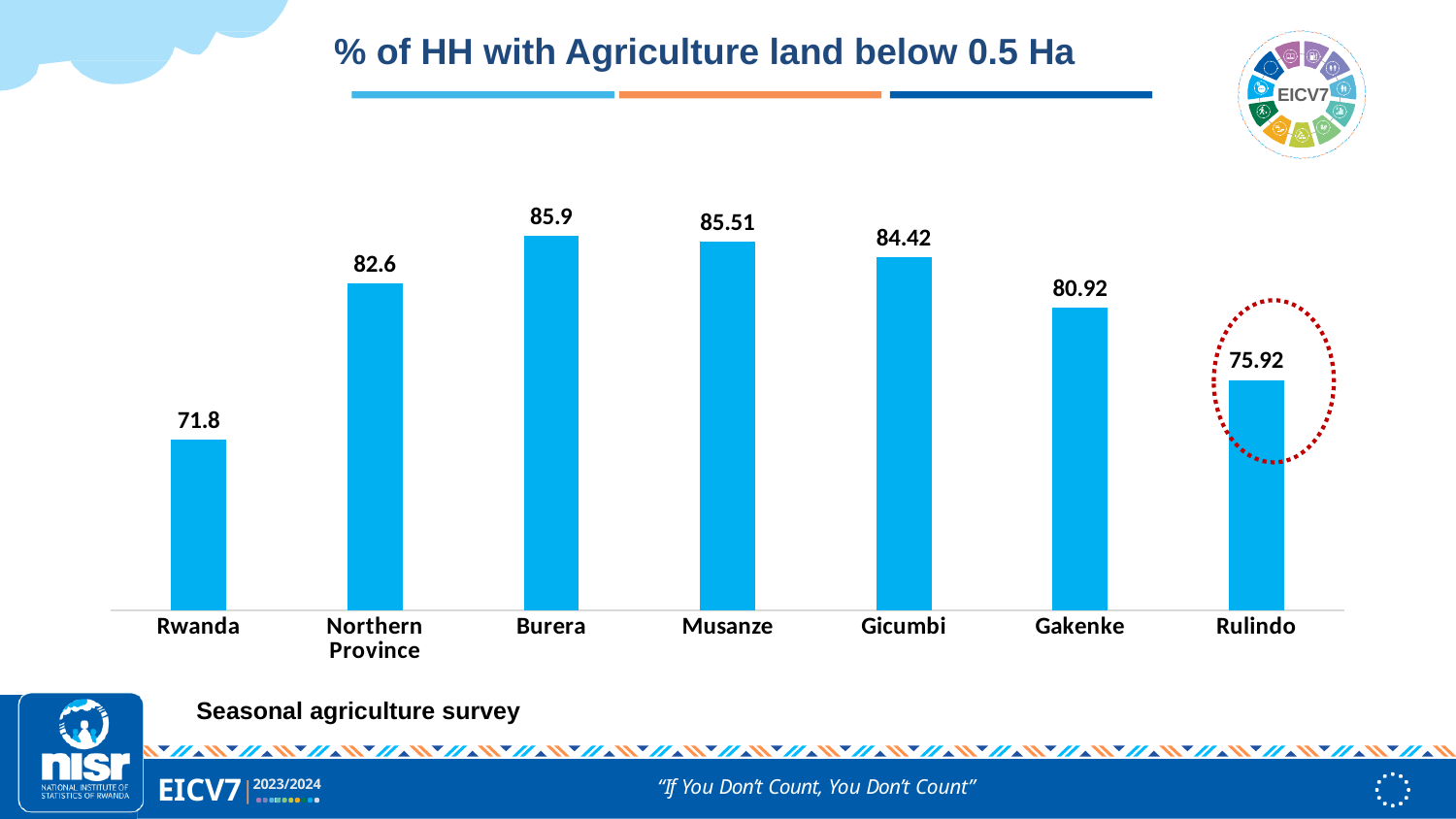
What is the difference between the values for Burera and Rulindo? 9.98 What is the value for Northern Province? 82.6 What is the value for Gicumbi? 84.42 What is the value for Rwanda? 71.8 Which is larger, the value for Gakenke or the value for Rulindo? Gakenke Which category has the highest value? Burera What kind of chart is shown on the slide? Bar chart What is the title of the chart? % of HH with Agriculture land below 0.5 Ha What is the value for Rulindo? 75.92 How many categories are shown on the x axis? 7 Which category has the lowest value? Rwanda What is the difference between the values for Northern Province and Rwanda? 10.8